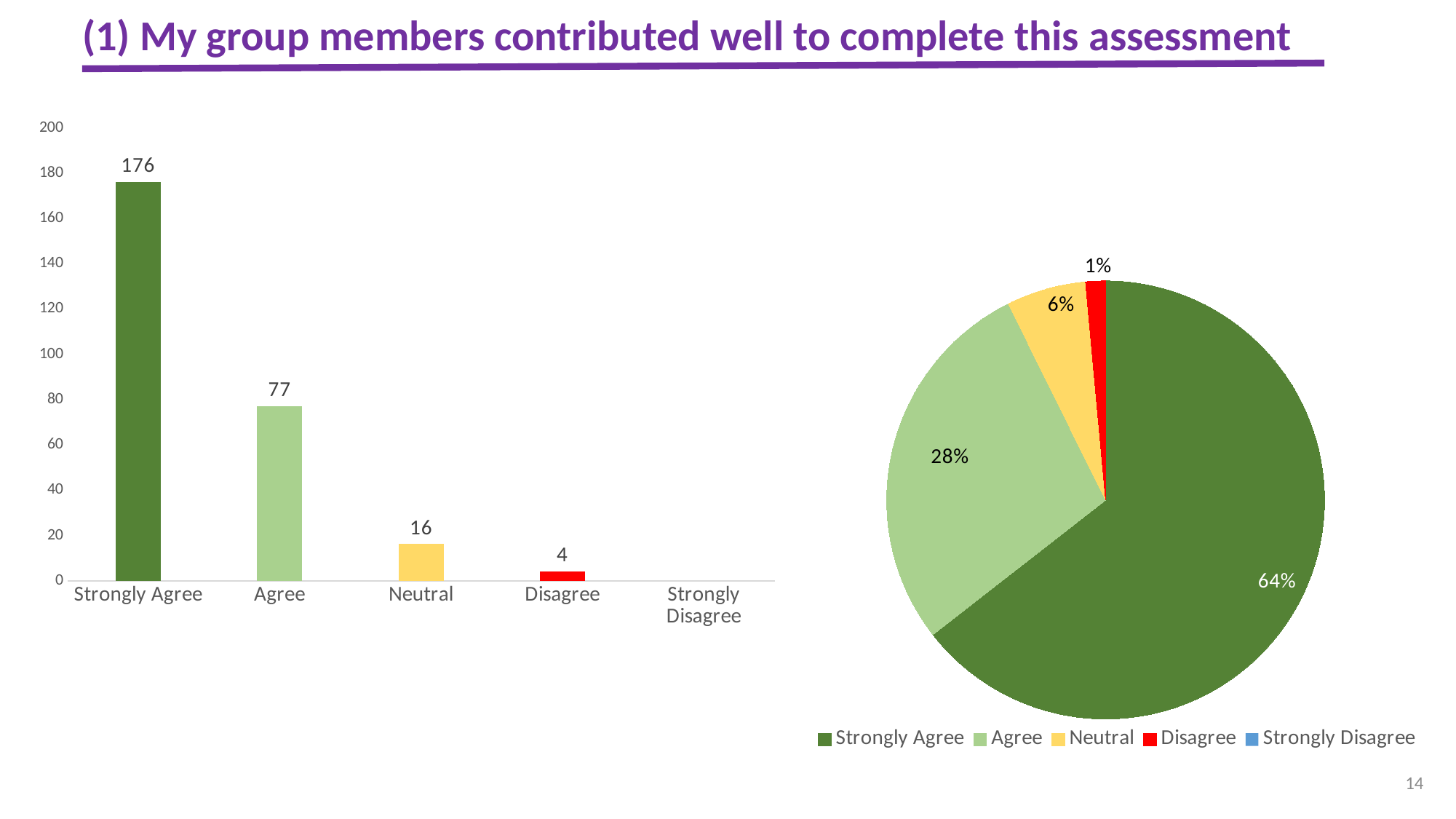
In the pie chart on the right, what share does Strongly Agree have? 64% In the bar chart on the left, what is the value for Strongly Agree? 176 How many categories are shown on the x axis of the bar chart on the left? 5 In the bar chart on the left, which category has the highest value? Strongly Agree In the bar chart on the left, which is larger, the value for Neutral or the value for Disagree? Neutral How many entries does the legend of the pie chart on the right list? 5 In the bar chart on the left, what is the value for Disagree? 4 In the pie chart on the right, what share does Agree have? 28% In the bar chart on the left, what is the value for Neutral? 16 In the bar chart on the left, what is the difference between the values for Strongly Agree and Agree? 99 In the bar chart on the left, what is the value for Agree? 77 What kind of chart is on the left side of the slide? Bar chart